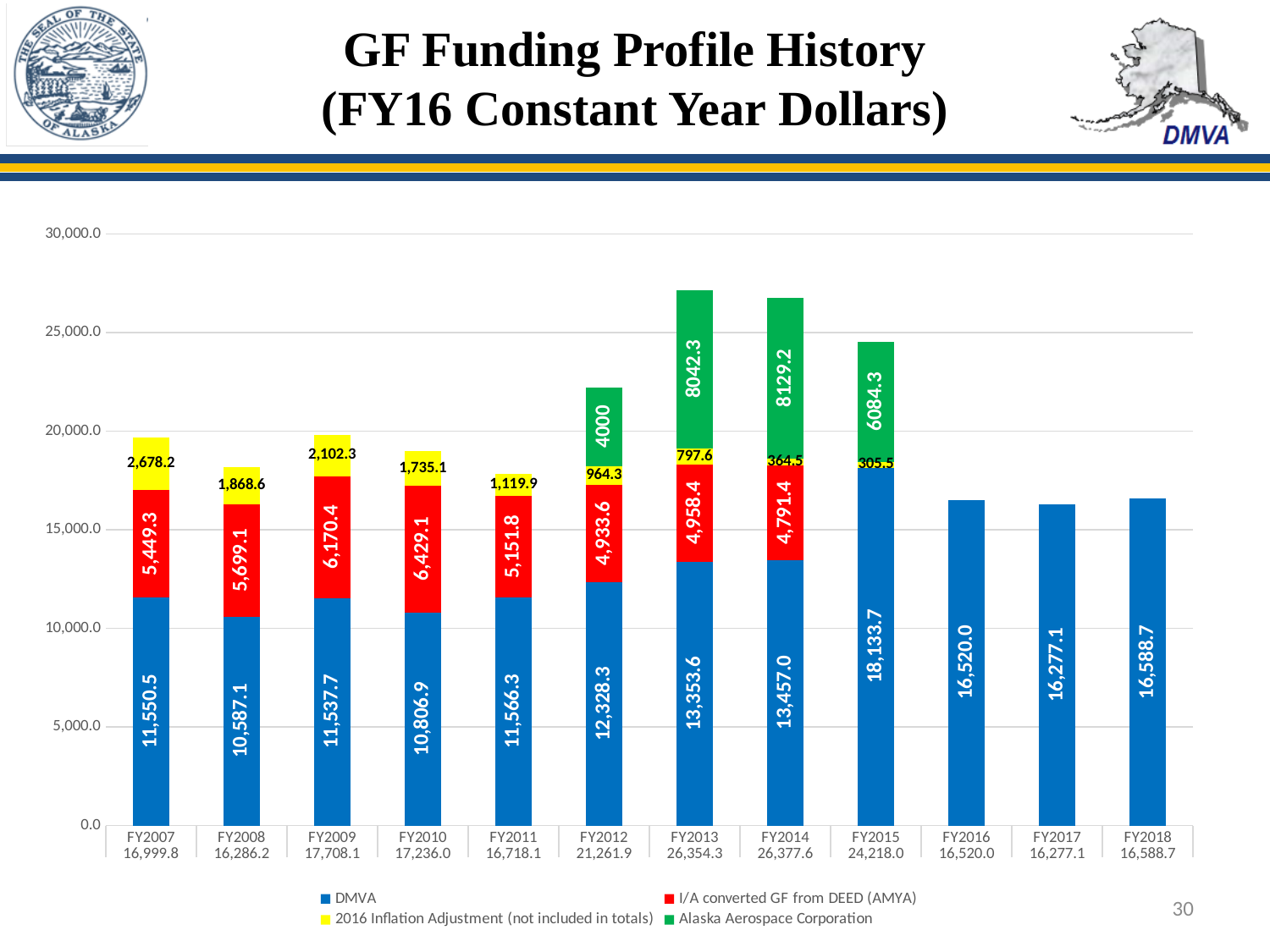
How many series does the legend list? 4 What is the difference between the Alaska Aerospace Corporation values for FY2014 and FY2013? 86.9 Which year has the larger I/A converted GF from DEED (AMYA) value, FY2009 or FY2011? FY2009 What kind of chart is shown on the slide? Stacked bar chart Is the total height of the FY2013 bar greater or less than 25,000.0? greater In which fiscal year is the DMVA value lowest? FY2008 How many fiscal years are shown on the x axis? 12 What is the 2016 Inflation Adjustment value for FY2007? 2,678.2 What is the DMVA value for FY2015? 18,133.7 What is the I/A converted GF from DEED (AMYA) value for FY2010? 6,429.1 What is the Alaska Aerospace Corporation value for FY2013? 8042.3 In which fiscal year is the DMVA value highest? FY2015